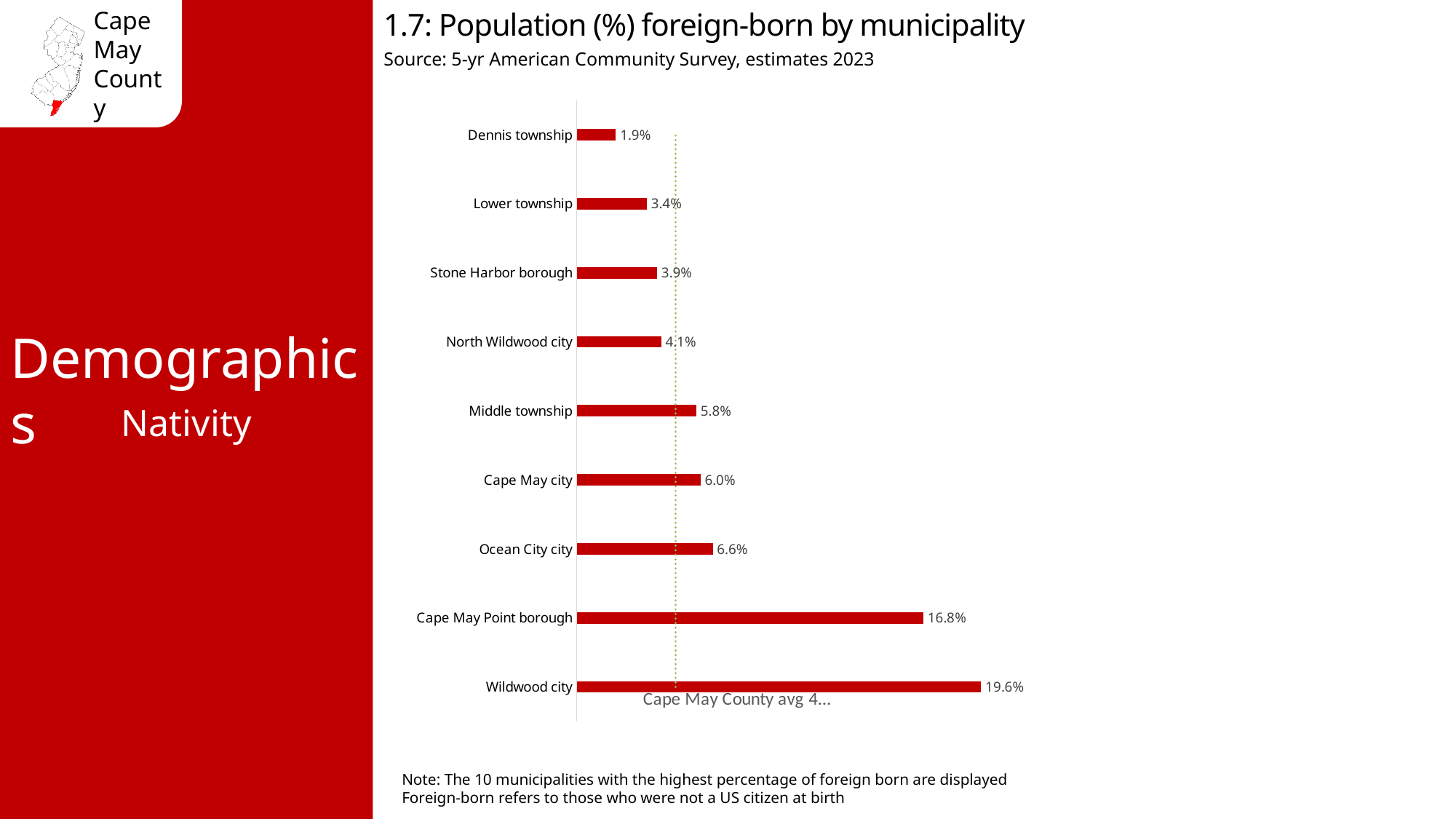
How many municipalities are plotted in the chart? 9 Which has a higher foreign-born percentage, Cape May city or North Wildwood city? Cape May city What is the foreign-born percentage shown for Middle township? 5.8% What value is shown for Stone Harbor borough? 3.9% What percentage of the population is foreign-born in Wildwood city? 19.6% What is the source of the data cited below the chart title? 5-yr American Community Survey, estimates 2023 Which municipality has the highest percentage of foreign-born population? Wildwood city Which municipality has the lowest percentage of foreign-born population? Dennis township What is the difference between the foreign-born percentages of Wildwood city and Cape May Point borough? 2.8% What type of chart is used on this slide? Bar chart Which has a larger value, Lower township or Middle township? Middle township What is the difference between the values for Ocean City city and Dennis township? 4.7%